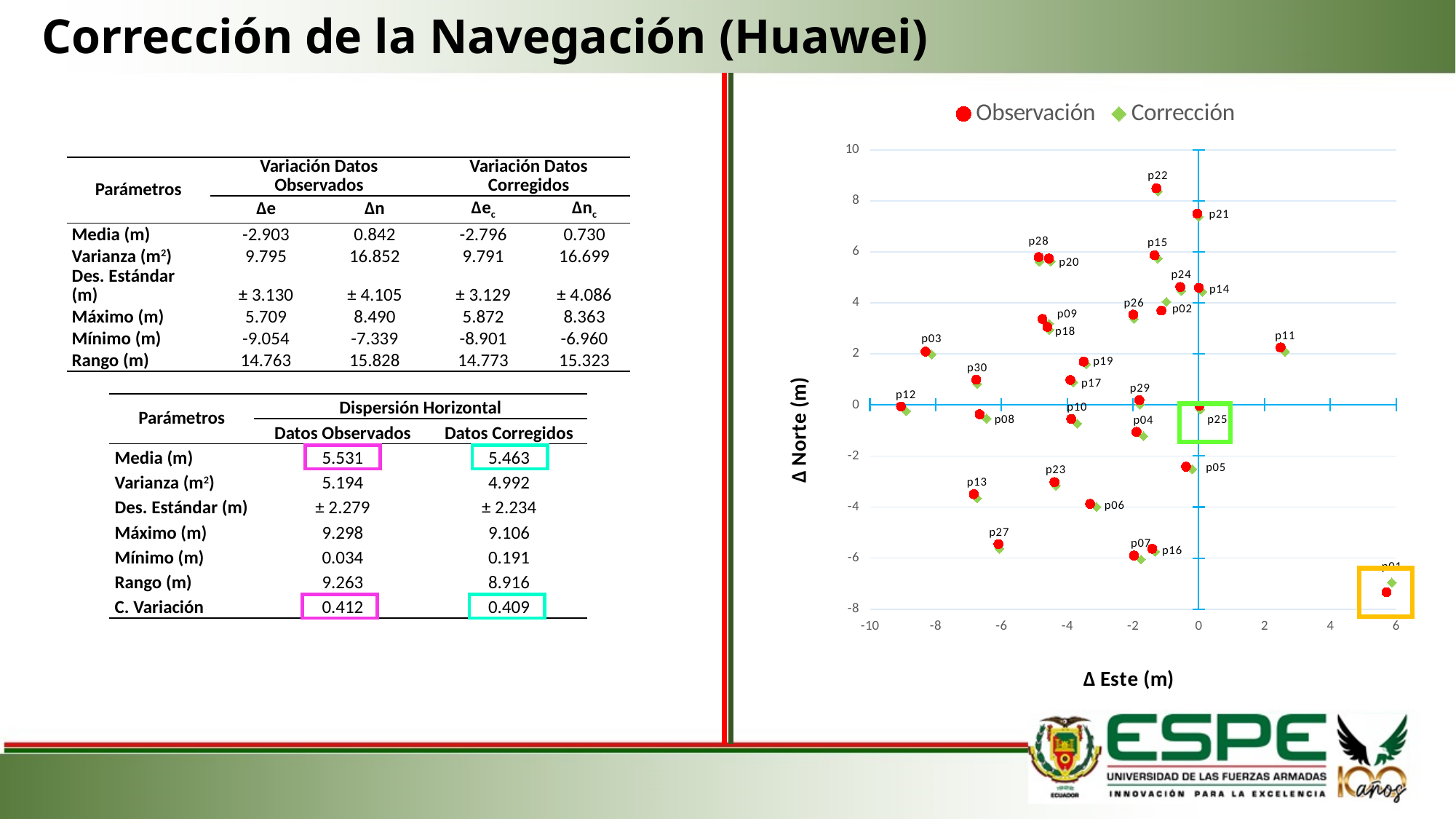
Which point has the lowest Δ Este value in the scatter chart? p12 Is the Δ Este value for p11 greater or less than 2? greater What kind of chart is shown on the right side of the slide? scatter chart Which point has a larger Δ Norte value, p22 or p21? p22 How many labeled points (p01 to p30) are plotted in the scatter chart? 30 How many series does the legend of the scatter chart list? 2 Is the Δ Norte value for p22 greater or less than 8? greater Is the Δ Norte value for p01 greater or less than -6? less Which point has the highest Δ Norte value in the scatter chart? p22 Which point has the lowest Δ Norte value in the scatter chart? p01 What is the title of the vertical axis of the scatter chart? Δ Norte (m) What are the two series named in the legend of the scatter chart? Observación and Corrección